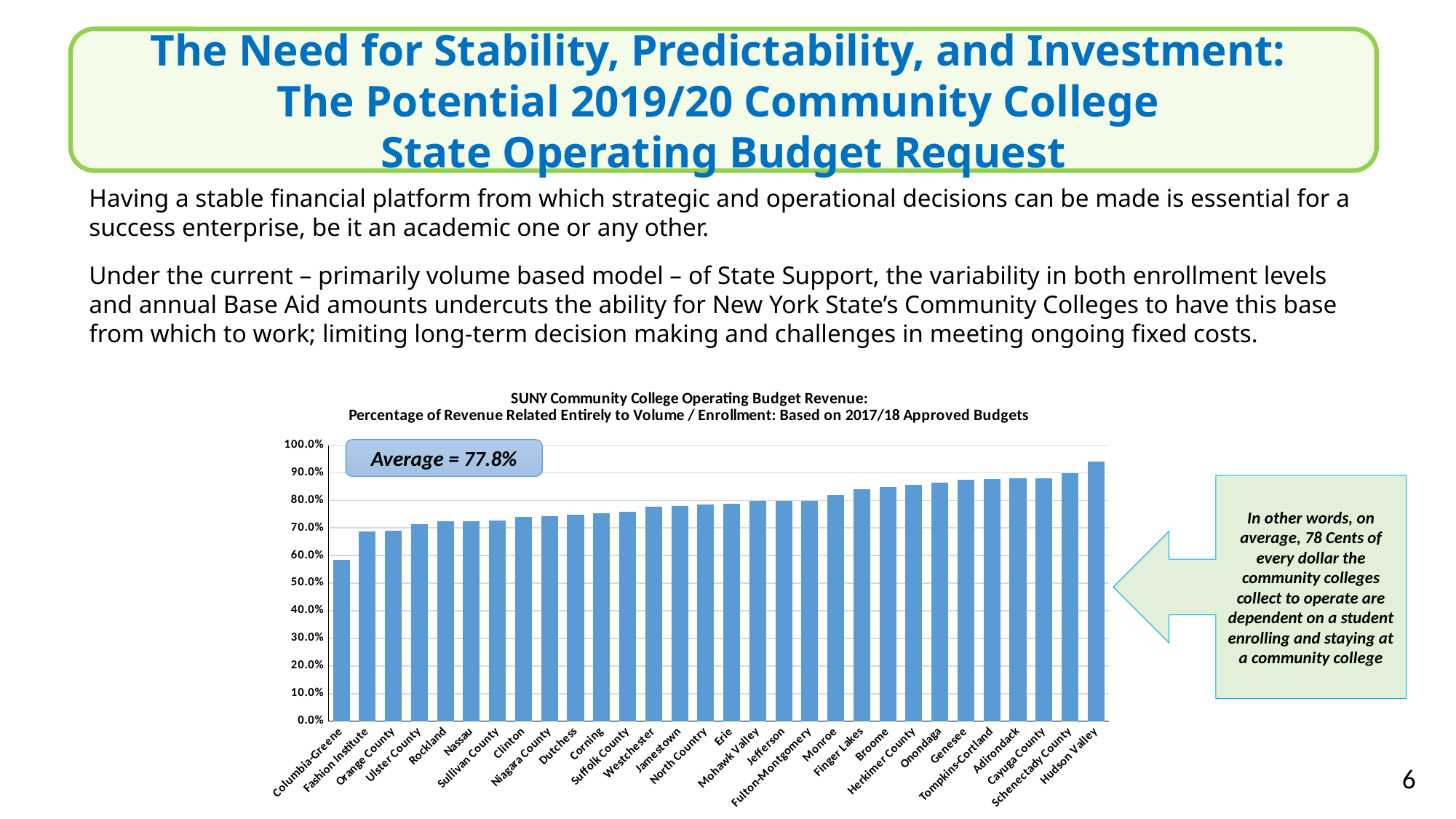
Is the value for Columbia-Greene greater or less than 60.0%? less According to the chart title, which approved budgets is the data based on? 2017/18 Approved Budgets What kind of chart is shown on the slide? Bar chart How many community colleges are shown on the x axis of the chart? 30 Do the bar values rise or fall moving from left to right along the x axis? Rise Which has a larger value, Hudson Valley or Columbia-Greene? Hudson Valley What average value is printed on the chart? 77.8% Which community college has the highest percentage of revenue related to volume/enrollment? Hudson Valley Is the value for Fashion Institute greater or less than 70.0%? less Is the value for Hudson Valley greater or less than 90.0%? greater Which community college has the lowest percentage of revenue related to volume/enrollment? Columbia-Greene